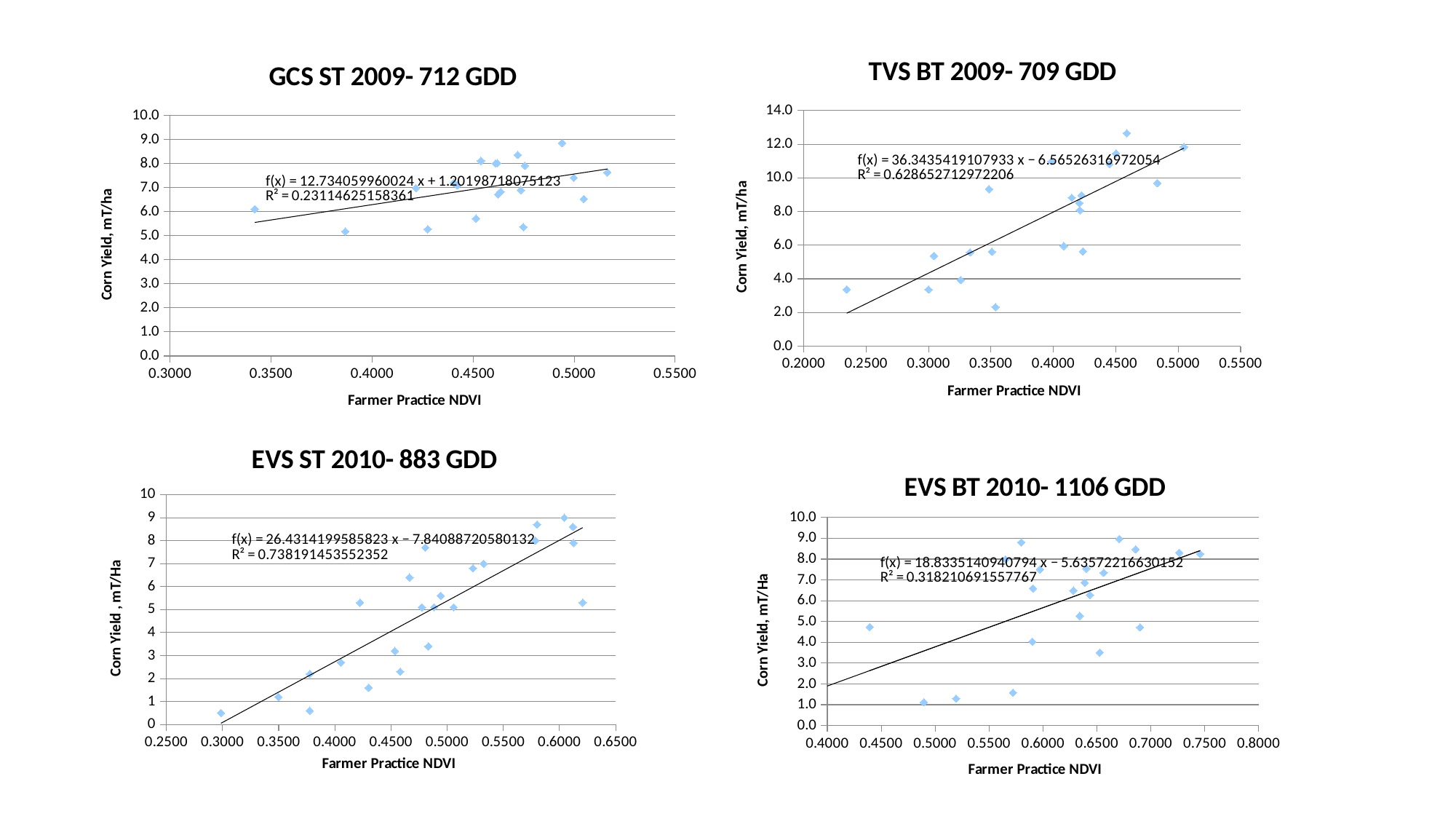
What kind of chart is the GCS ST 2009- 712 GDD chart? scatter chart In the TVS BT 2009- 709 GDD chart, what is the R² value printed on the chart? 0.628652712972206 In the GCS ST 2009- 712 GDD chart, what is the R² value printed on the chart? 0.23114625158361 How many charts are shown on the slide? 4 In the TVS BT 2009- 709 GDD chart, is the highest plotted corn yield greater or less than 12.0? greater What is the x-axis title of the EVS BT 2010- 1106 GDD chart? Farmer Practice NDVI In the EVS ST 2010- 883 GDD chart, is the lowest plotted corn yield greater or less than 1? less In the EVS BT 2010- 1106 GDD chart, what is the R² value printed on the chart? 0.318210691557767 In the EVS ST 2010- 883 GDD chart, what is the R² value printed on the chart? 0.738191453552352 Which of the four charts has the lowest R² value? GCS ST 2009- 712 GDD Which of the four charts has the highest R² value? EVS ST 2010- 883 GDD In the EVS ST 2010- 883 GDD chart, does corn yield rise or fall as Farmer Practice NDVI increases along the trendline? rise